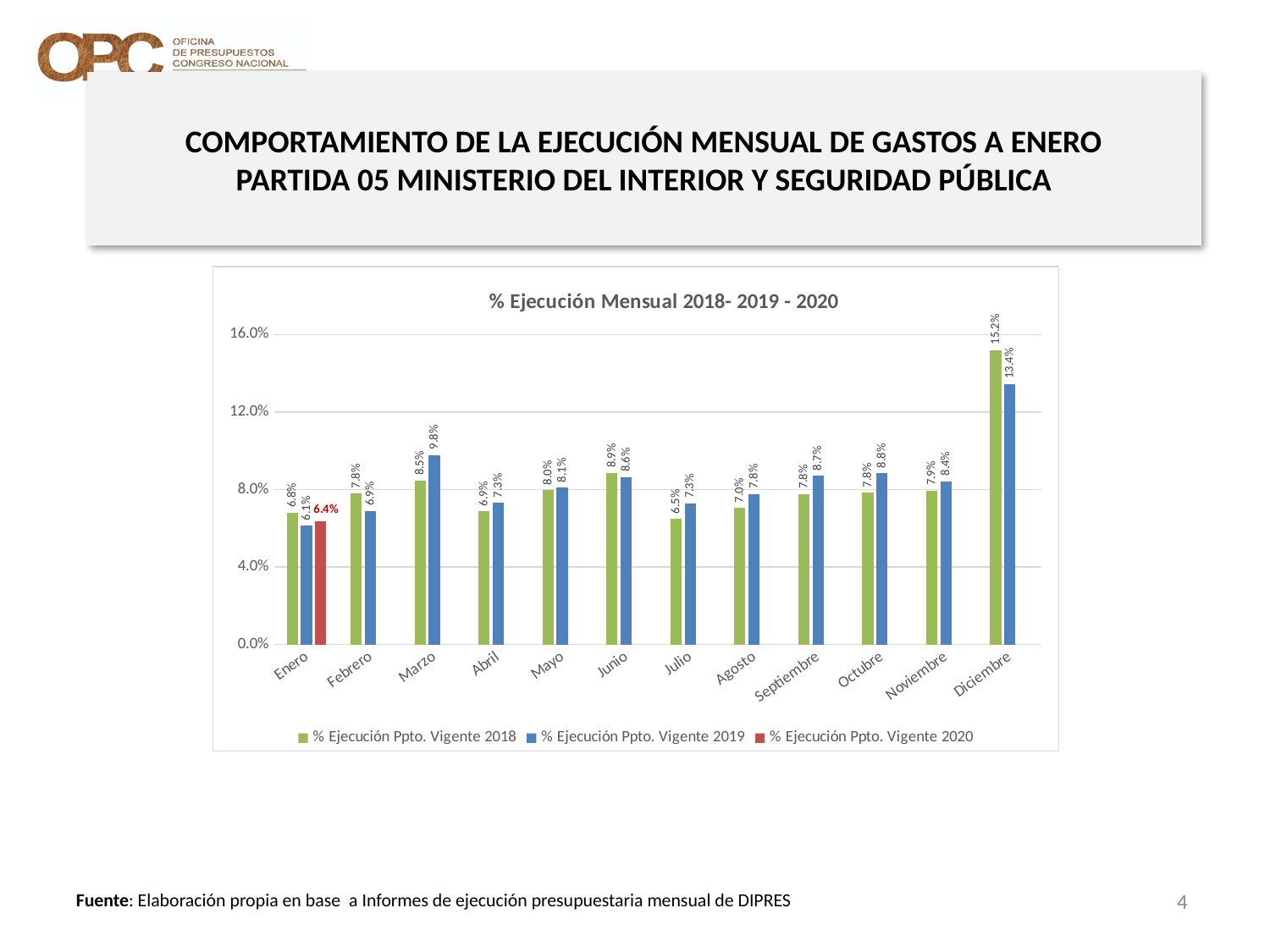
What is the title of the chart? % Ejecución Mensual 2018- 2019 - 2020 What is the difference between the 2018 and 2019 values in Diciembre? 1.8% Is the value for % Ejecución Ppto. Vigente 2019 in Diciembre greater or less than 12.0%? greater Which month has the lowest value for % Ejecución Ppto. Vigente 2018? Julio How many months are shown on the x axis? 12 In Enero, which is larger: the 2018 value or the 2019 value? 2018 How many series does the legend list? 3 What is the value for % Ejecución Ppto. Vigente 2019 in Marzo? 9.8% Which month has the highest value for % Ejecución Ppto. Vigente 2019? Diciembre What kind of chart is shown on the slide? Bar chart What is the value for % Ejecución Ppto. Vigente 2018 in Diciembre? 15.2% What is the value for % Ejecución Ppto. Vigente 2020 in Enero? 6.4%